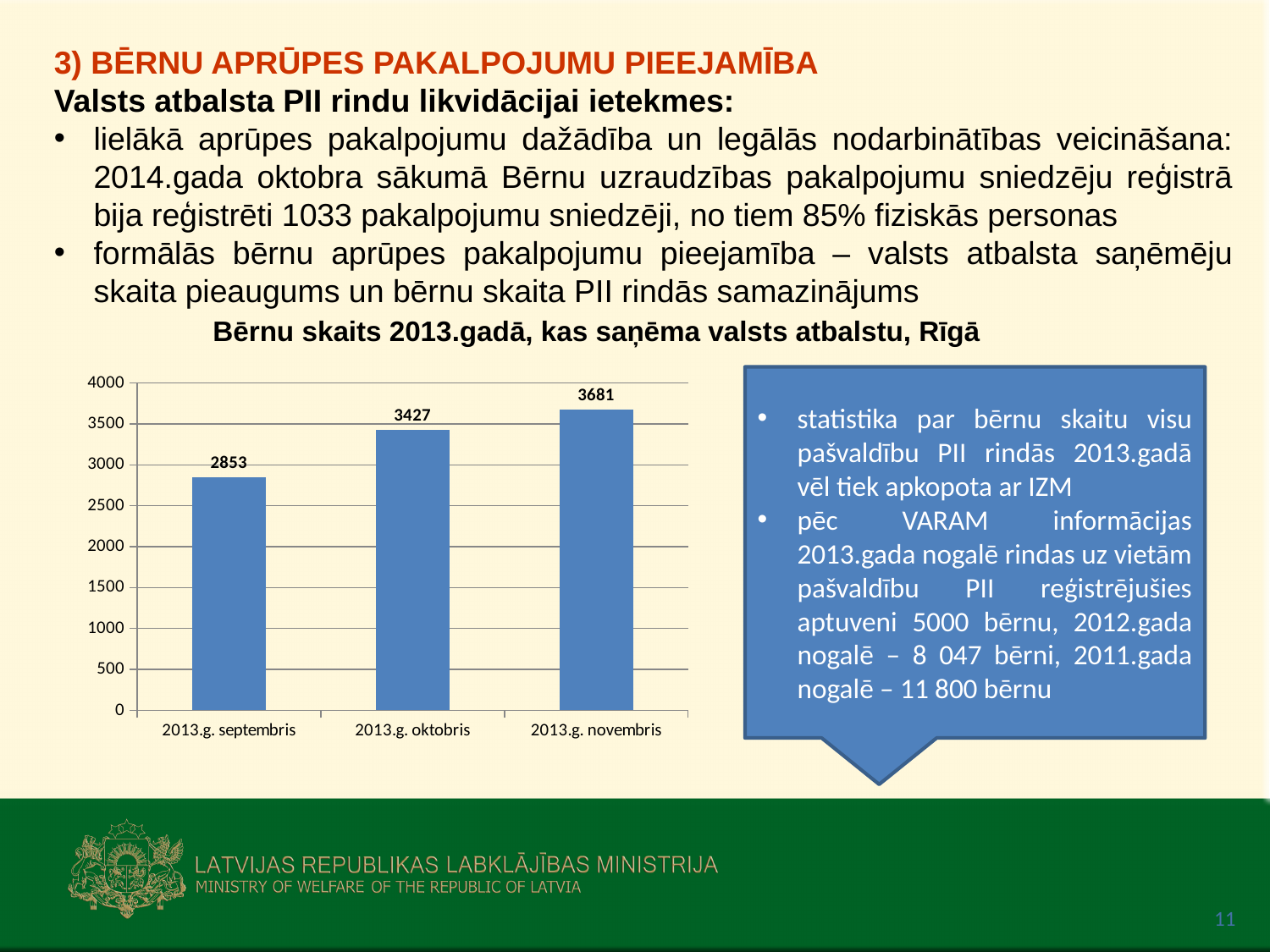
What kind of chart is shown on the slide? bar chart What is the value for 2013.g. oktobris? 3427 Which month has the lowest value? 2013.g. septembris What is the difference between the values for 2013.g. novembris and 2013.g. septembris? 828 What is the value for 2013.g. septembris? 2853 Which month has the highest value? 2013.g. novembris What is the value for 2013.g. novembris? 3681 Is the value for 2013.g. septembris greater or less than 3000? less How many categories are shown on the x axis? 3 Which is larger, the value for 2013.g. oktobris or 2013.g. novembris? 2013.g. novembris What is the difference between the values for 2013.g. oktobris and 2013.g. septembris? 574 Do the values rise or fall from September to November 2013? rise